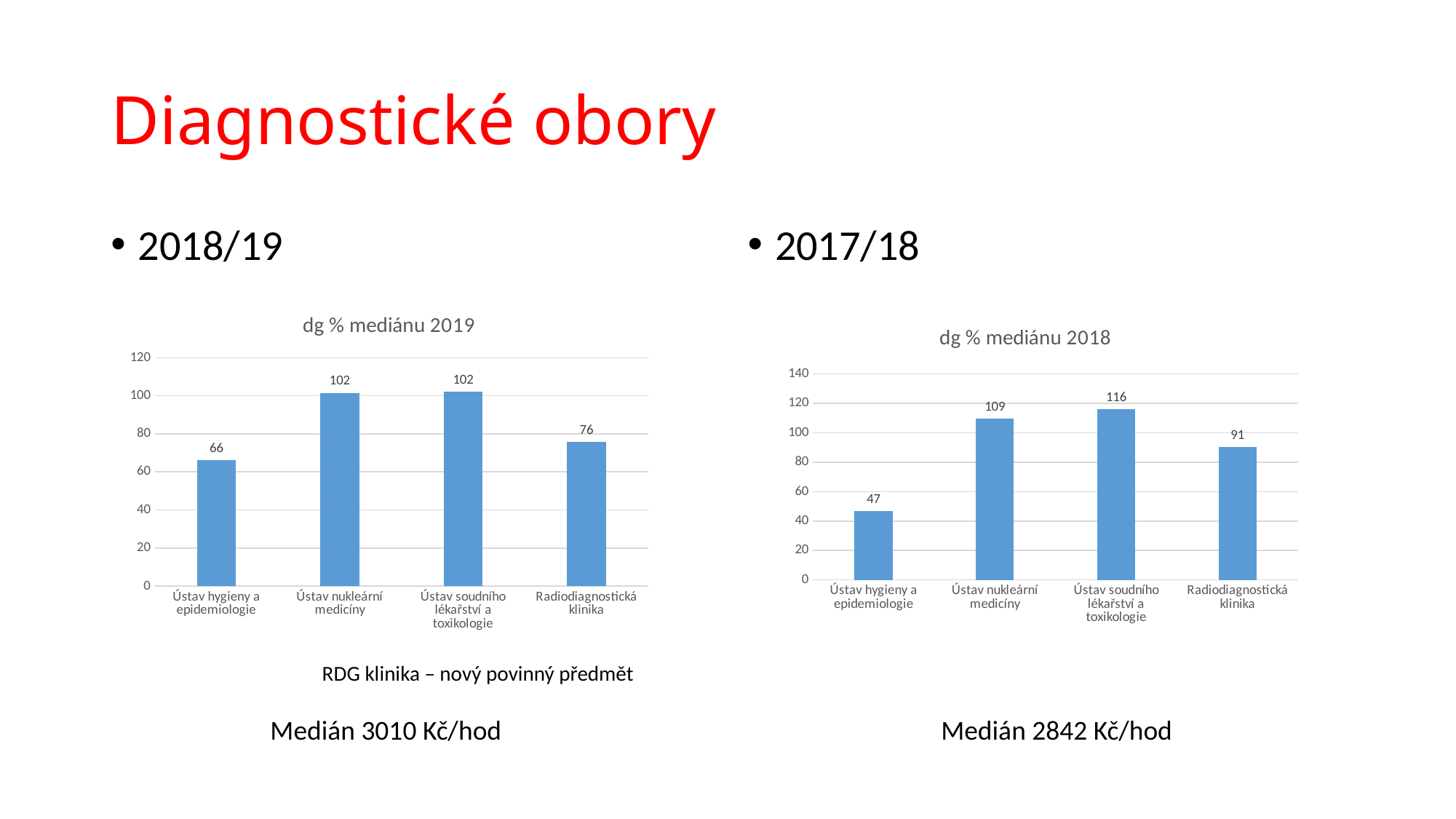
In the chart titled "dg % mediánu 2018", is the value for Radiodiagnostická klinika greater or less than 100? less In the chart titled "dg % mediánu 2018", what is the value for Ústav soudního lékařství a toxikologie? 116 In the chart titled "dg % mediánu 2018", which is larger: the value for Ústav nukleární medicíny or Radiodiagnostická klinika? Ústav nukleární medicíny In the chart titled "dg % mediánu 2019", what is the value for Radiodiagnostická klinika? 76 In the chart titled "dg % mediánu 2019", what is the difference between the values for Ústav nukleární medicíny and Ústav hygieny a epidemiologie? 36 In the chart titled "dg % mediánu 2018", what is the difference between the values for Ústav nukleární medicíny and Radiodiagnostická klinika? 18 In the chart titled "dg % mediánu 2018", what is the value for Ústav hygieny a epidemiologie? 47 What kind of chart is the chart titled "dg % mediánu 2018"? Bar chart In the chart titled "dg % mediánu 2019", which category has the lowest value? Ústav hygieny a epidemiologie In the chart titled "dg % mediánu 2018", which category has the highest value? Ústav soudního lékařství a toxikologie How many categories are shown in the chart titled "dg % mediánu 2019"? 4 In the chart titled "dg % mediánu 2019", what is the value for Ústav hygieny a epidemiologie? 66